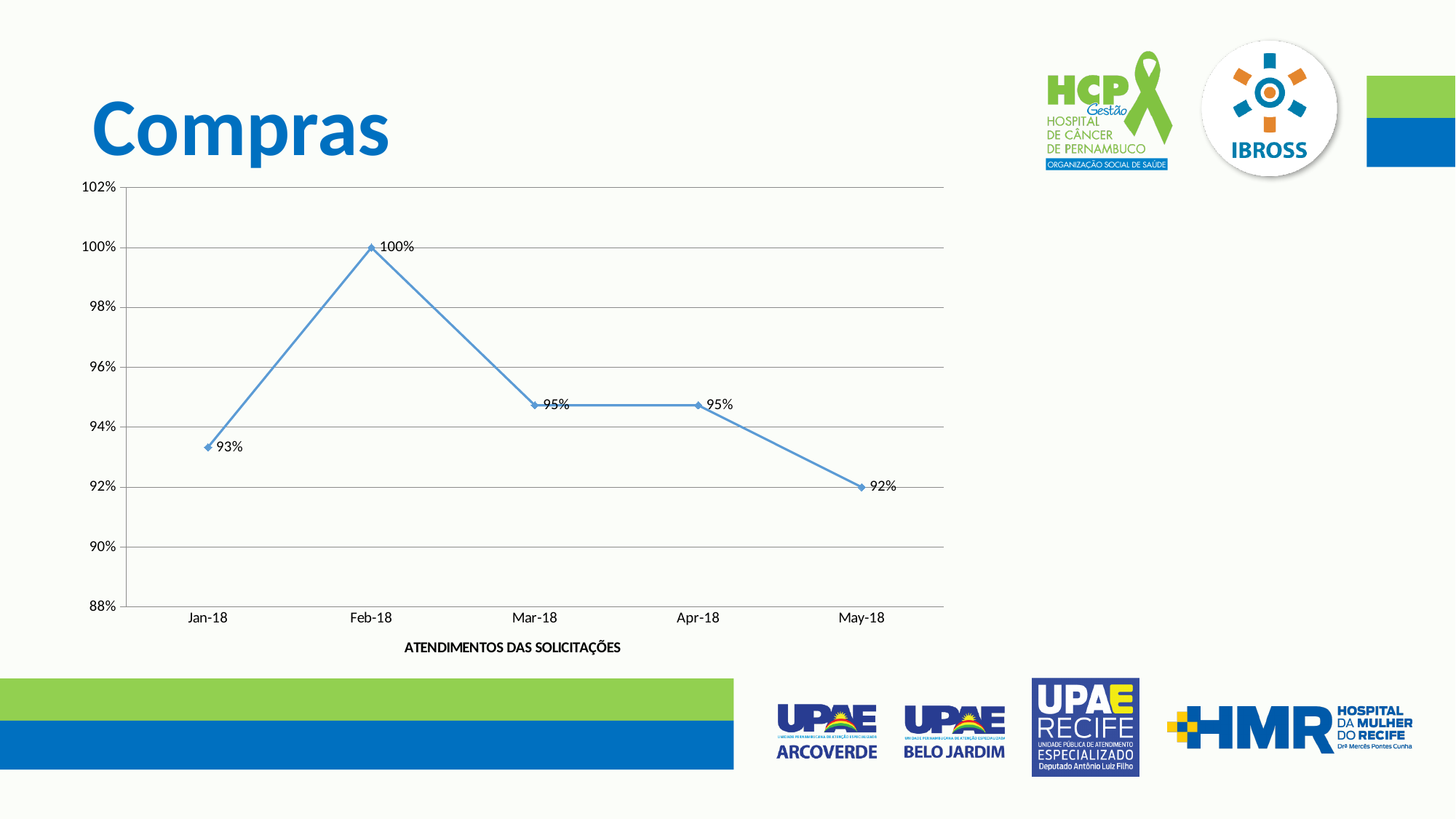
What is the value for May-18? 92% Which is larger, the value for Jan-18 or the value for Apr-18? Apr-18 What kind of chart is shown? line chart Which month has the highest value? Feb-18 Which month has the lowest value? May-18 What is the value for Mar-18? 95% Is the value for Jan-18 greater or less than 94%? less What is the value for Jan-18? 93% What is the label shown below the x axis of the chart? ATENDIMENTOS DAS SOLICITAÇÕES How many months are plotted on the x axis? 5 What is the difference between the values for Feb-18 and May-18? 8% What is the value for Feb-18? 100%